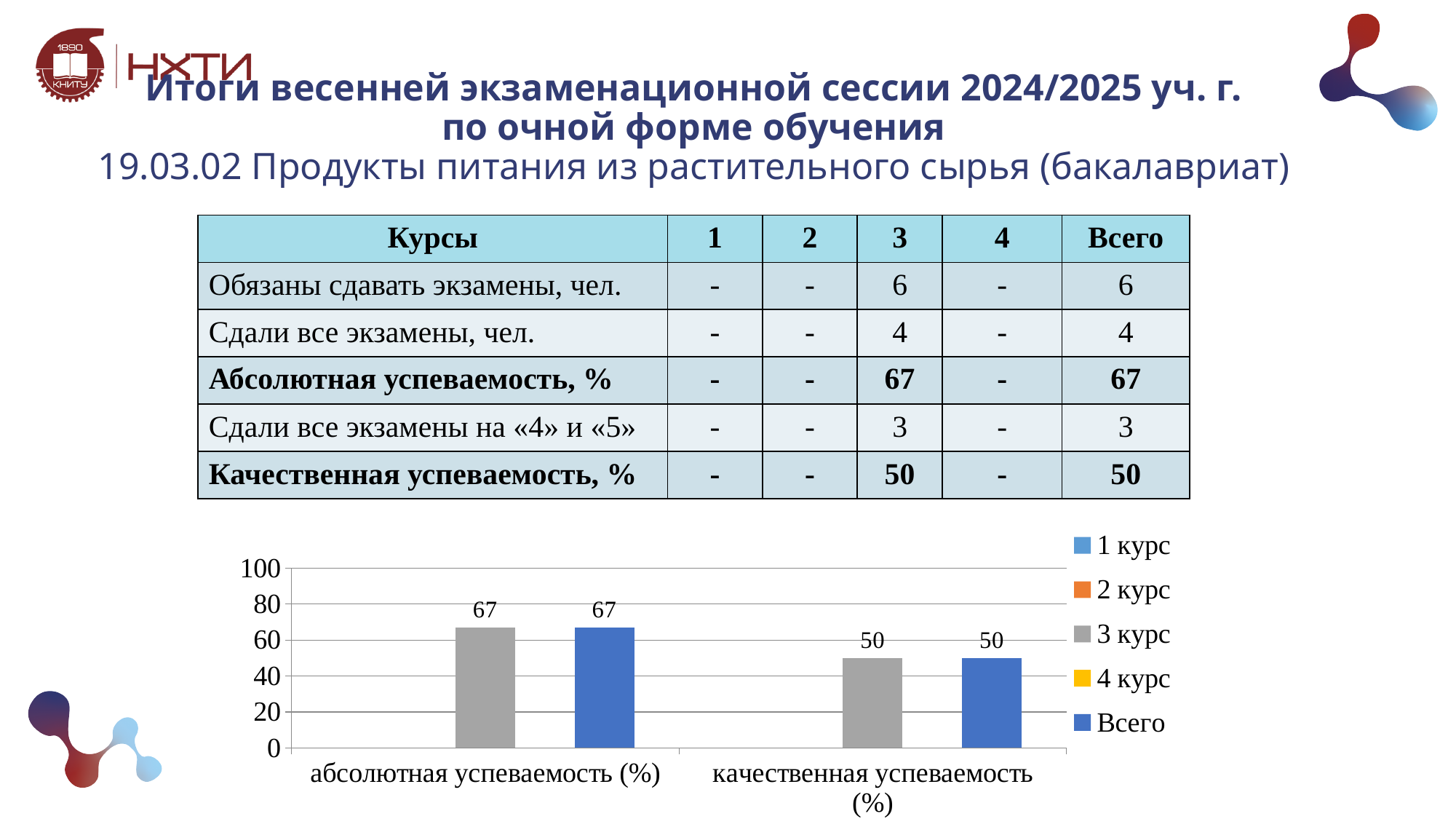
How many categories are shown on the x axis of the chart? 2 Which legend entry is shown in grey in the chart? 3 курс What is the value of the 3 курс bar for качественная успеваемость (%)? 50 What is the difference between the Всего value for абсолютная успеваемость (%) and the Всего value for качественная успеваемость (%)? 17 What is the value of the 3 курс bar for абсолютная успеваемость (%)? 67 Which is larger for the 3 курс series: абсолютная успеваемость (%) or качественная успеваемость (%)? абсолютная успеваемость (%) What is the value of the Всего bar for качественная успеваемость (%)? 50 What kind of chart is shown on the slide? bar chart Is the Всего value for абсолютная успеваемость (%) greater or less than 60? greater What is the value of the Всего bar for абсолютная успеваемость (%)? 67 Do the values for the Всего series rise or fall from абсолютная успеваемость (%) to качественная успеваемость (%)? fall How many series does the chart legend list? 5